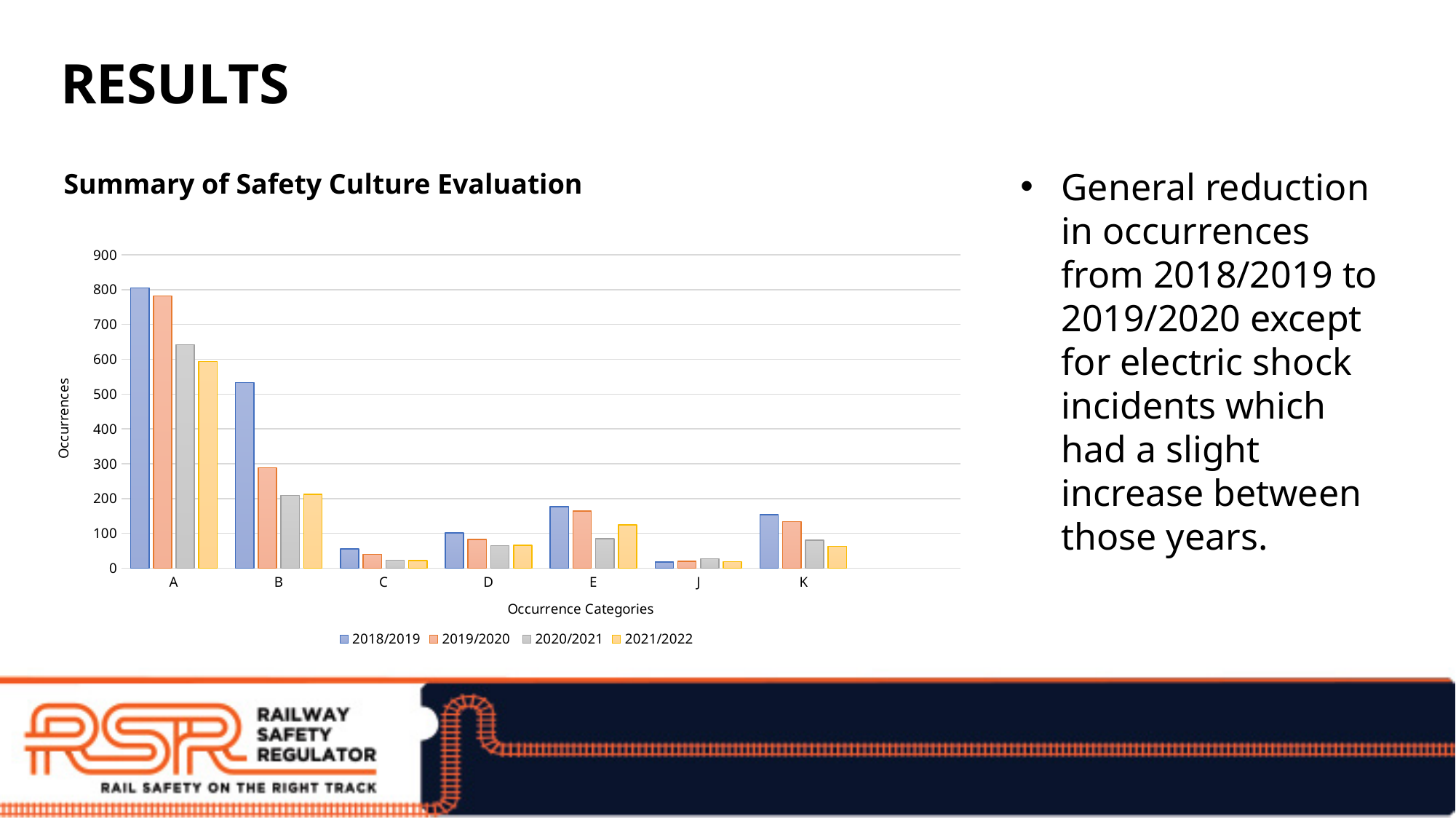
Is the 2019/2020 value for category B greater or less than 400? less Which occurrence category has the highest number of occurrences for 2018/2019? A For category B, which is larger: the 2018/2019 value or the 2019/2020 value? 2018/2019 Which occurrence category has the lowest number of occurrences for 2018/2019? J What kind of chart is shown on the slide? Bar chart How many series does the legend of the chart list? 4 How many occurrence categories are shown on the x axis of the chart? 7 For category A, do the occurrences rise or fall from 2018/2019 through 2021/2022? fall Is the 2018/2019 value for category A greater or less than 700? greater Is the 2020/2021 value for category A greater or less than 600? greater For category E, which is larger: the 2018/2019 value or the 2021/2022 value? 2018/2019 What is the title of the chart? Summary of Safety Culture Evaluation